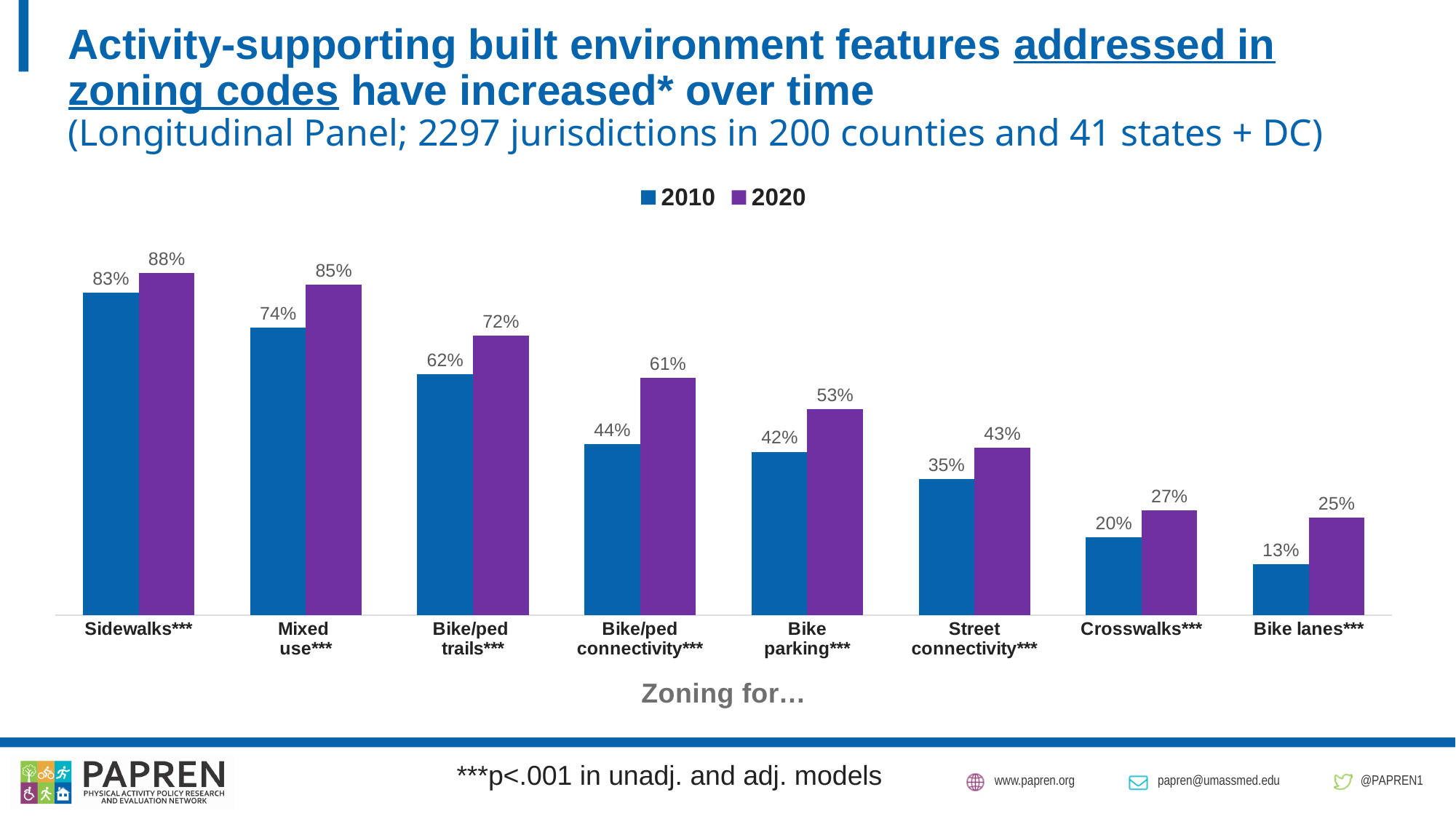
Which is larger: the 2010 value for Mixed use*** or the 2020 value for Bike/ped trails***? 2010 value for Mixed use*** What is the x-axis title of the chart? Zoning for… Which category has the lowest 2020 value? Bike lanes*** What is the difference between the 2020 and 2010 values for Bike lanes***? 12% How many series does the legend list? 2 What kind of chart is shown on the slide? Bar chart What is the 2010 value for Bike/ped connectivity***? 44% Which category has the highest 2010 value? Sidewalks*** What is the 2020 value for Sidewalks***? 88% What is the difference between the 2020 and 2010 values for Bike/ped connectivity***? 17% How many categories are shown on the x axis? 8 What is the 2020 value for Crosswalks***? 27%